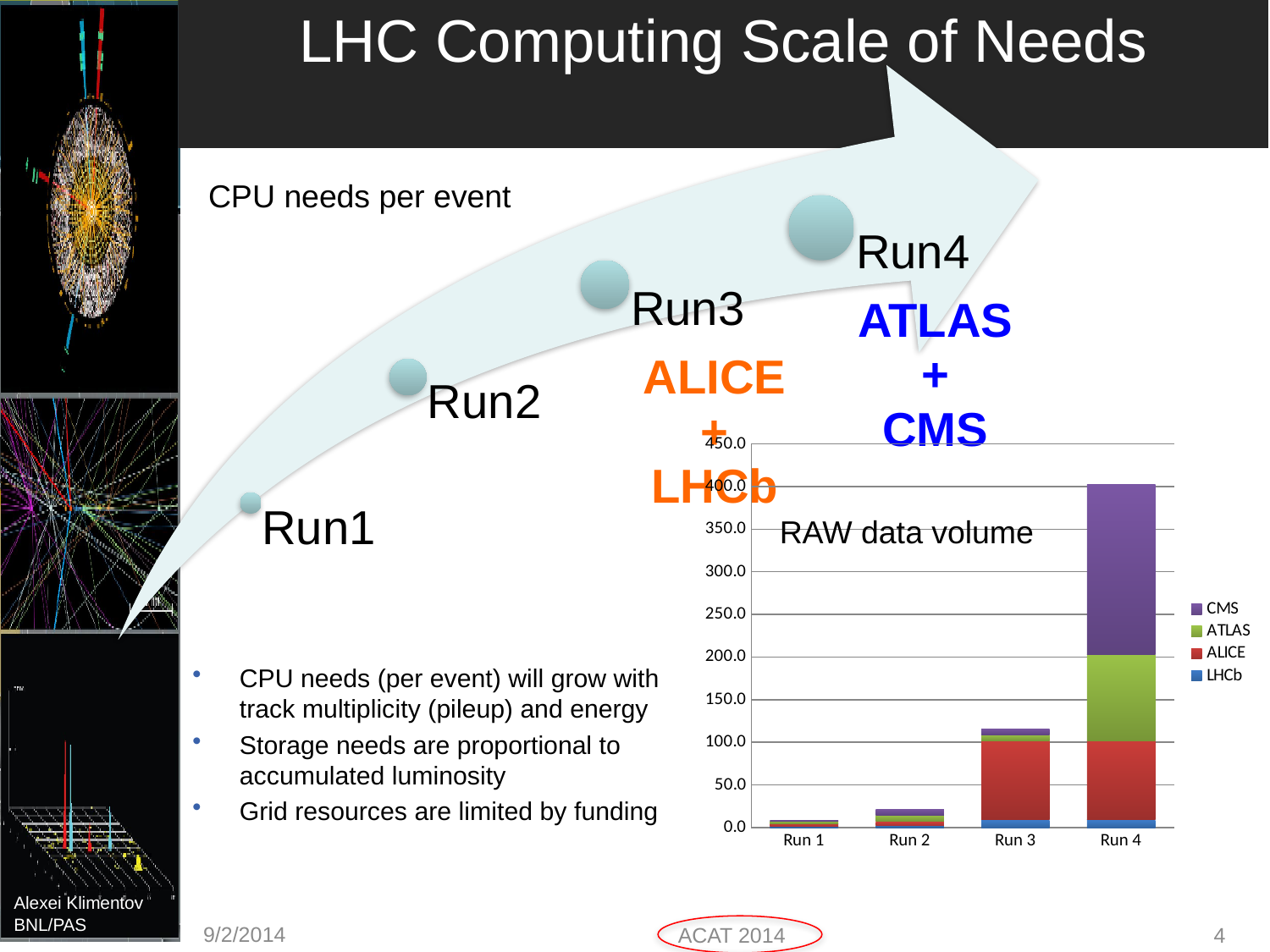
Do the total RAW data volumes rise or fall from Run 1 to Run 4? rise Which series is shown in purple in the RAW data volume chart? CMS Which run has the highest total RAW data volume? Run 4 How many categories are shown on the x axis of the RAW data volume chart? 4 How many series does the legend of the RAW data volume chart list? 4 Is the total RAW data volume for Run 2 greater or less than 50.0? less What kind of chart is the RAW data volume chart? stacked bar chart Which series is listed last in the legend of the RAW data volume chart? LHCb Is the total RAW data volume for Run 3 greater or less than 100.0? greater Which has a larger total RAW data volume, Run 3 or Run 4? Run 4 Is the total RAW data volume for Run 4 greater or less than 350.0? greater Which run has the lowest total RAW data volume? Run 1